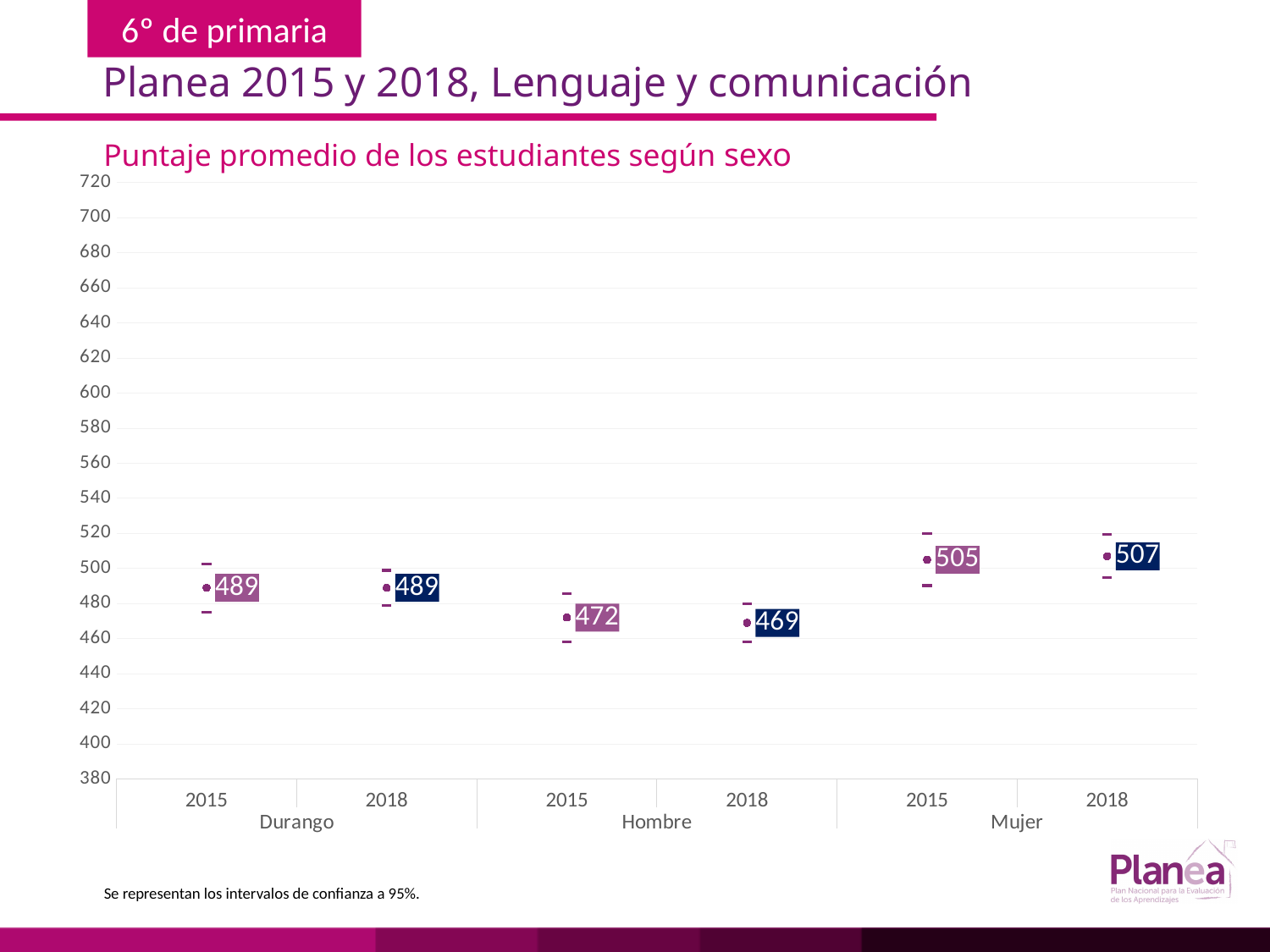
What is the difference between the Mujer 2015 score and the Mujer 2018 score? 2 What is the average score for Hombre in 2018? 469 Which is larger, the Hombre 2015 score or the Hombre 2018 score? Hombre 2015 What is the title of the chart? Puntaje promedio de los estudiantes según sexo What is the difference between the Mujer 2018 score and the Hombre 2018 score? 38 Which group and year has the lowest average score? Hombre 2018 What is the average score for Hombre in 2015? 472 Did the Durango average score change from 2015 to 2018? No, it stayed at 489 What is the average score for Durango in 2018? 489 Which group and year has the highest average score? Mujer 2018 What is the average score for Mujer in 2018? 507 How many data points are plotted on the chart? 6